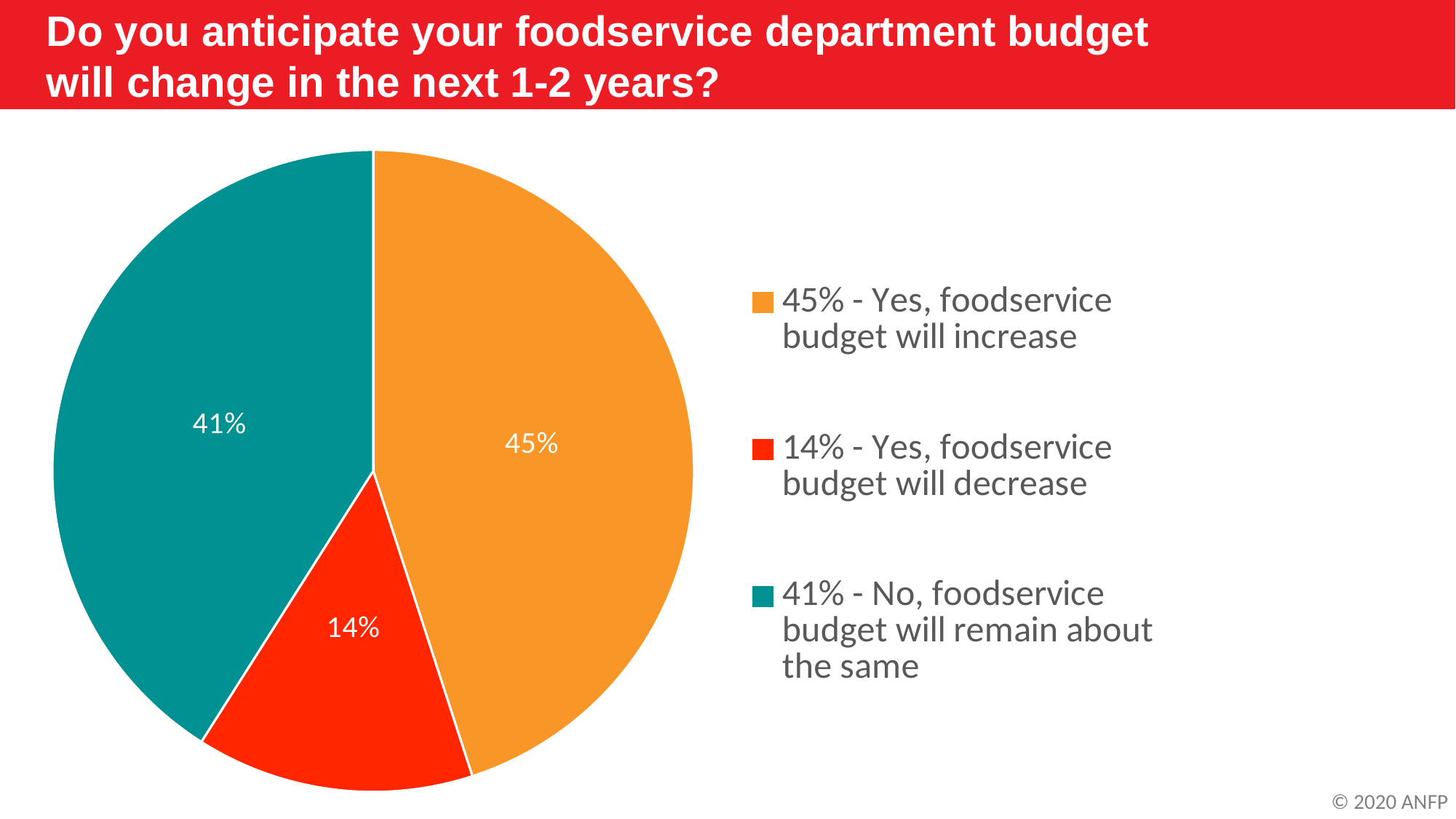
What is the title of the chart on the slide? Do you anticipate your foodservice department budget will change in the next 1-2 years? Which is larger: the share saying the budget will remain about the same or the share saying it will decrease? remain about the same Which response has the largest slice of the pie? Yes, foodservice budget will increase What share of respondents said their foodservice budget will increase? 45% How many slices does the pie chart have? 3 What kind of chart is shown on the slide? pie chart What colour is the slice for 'No, foodservice budget will remain about the same'? teal What share of respondents said their foodservice budget will remain about the same? 41% What is the difference in percentage points between the 'budget will increase' and 'budget will remain about the same' slices? 4 Which response has the smallest slice of the pie? Yes, foodservice budget will decrease What is the difference in percentage points between the 'budget will increase' and 'budget will decrease' slices? 31 What share of respondents said their foodservice budget will decrease? 14%